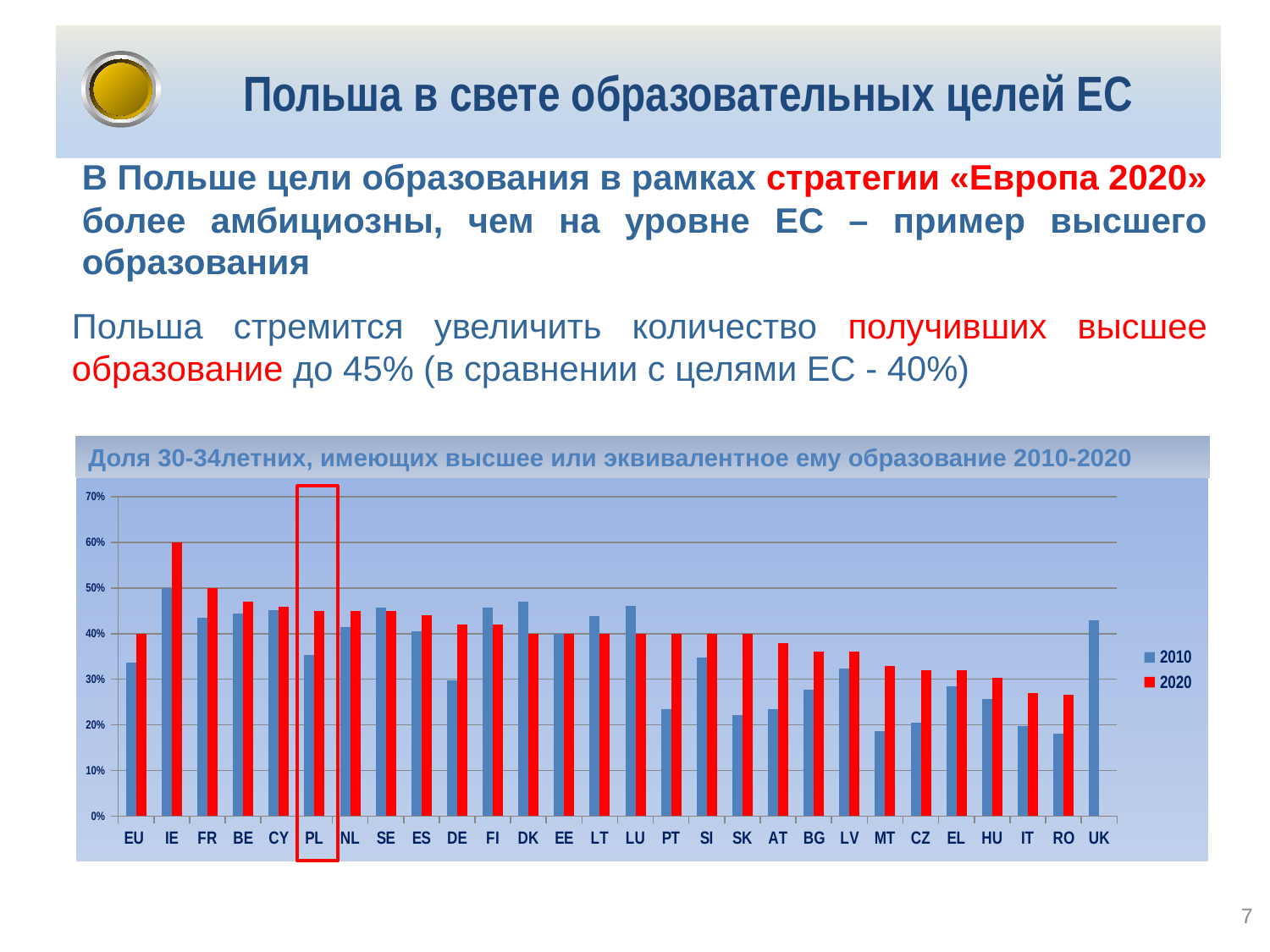
What is the 2020 value for EU? 40% Is the 2010 value for RO greater or less than 20%? less Which category has the highest 2020 value? IE Which category is outlined with a red box on the chart? PL What is the 2020 value for IE? 60% How many country/region categories are shown on the x axis? 28 Which colour represents the 2020 series in the legend? red Is the 2010 value for PL greater or less than 40%? less How many series does the legend list? 2 What kind of chart is shown on the slide? bar chart For PL, which is larger: the 2010 value or the 2020 value? 2020 Is the 2020 value for PL greater or less than 40%? greater